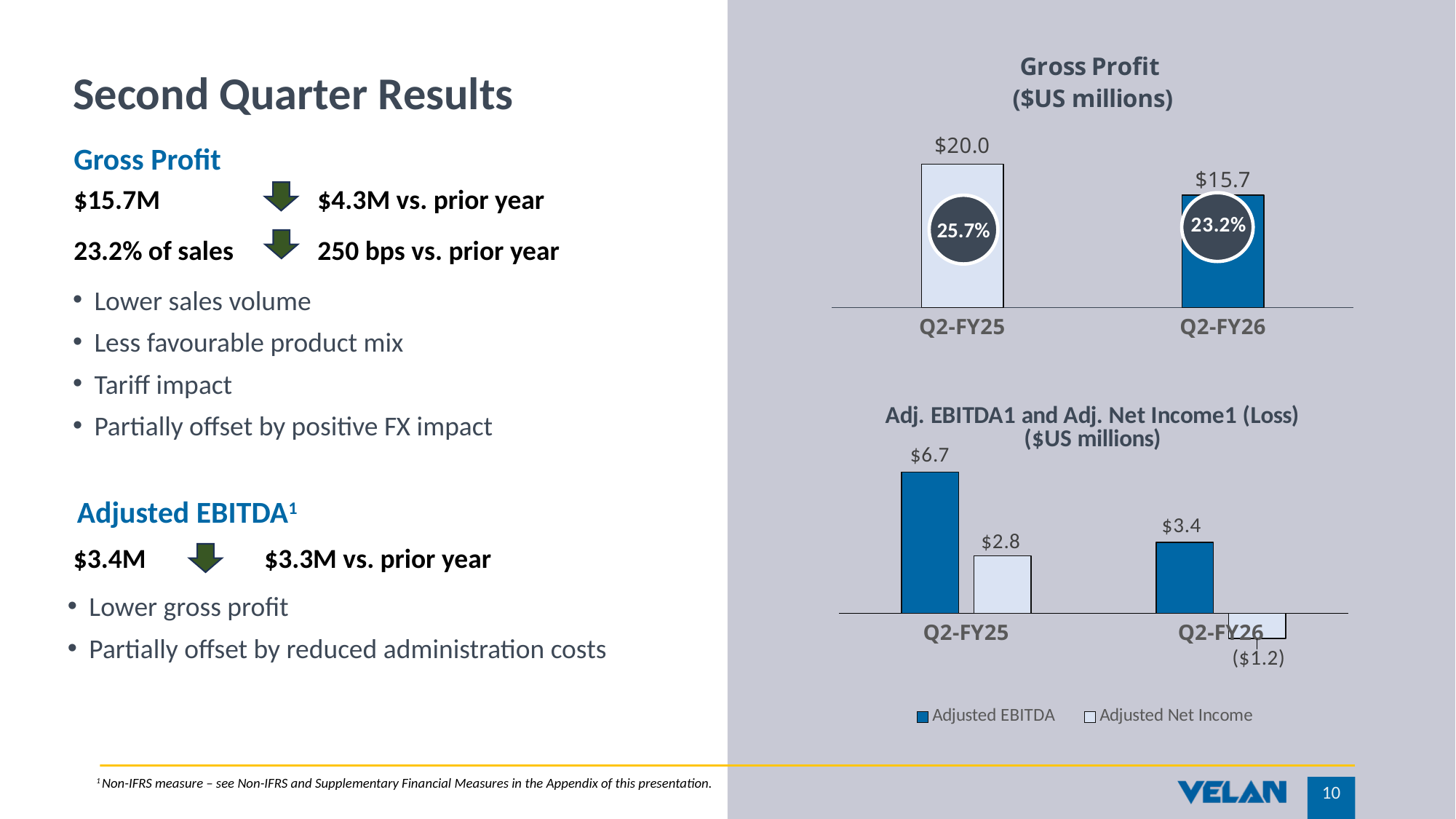
In the Adj. EBITDA and Adj. Net Income chart, does Adjusted EBITDA rise or fall from Q2-FY25 to Q2-FY26? Fall What type of chart is the Gross Profit chart? Bar chart In the Adj. EBITDA and Adj. Net Income chart, what is the Adjusted EBITDA for Q2-FY25? $6.7 In the Gross Profit chart, which quarter has the higher gross profit? Q2-FY25 In the Adj. EBITDA and Adj. Net Income chart, what is the Adjusted Net Income for Q2-FY26? ($1.2) In the Adj. EBITDA and Adj. Net Income chart, what is the Adjusted Net Income for Q2-FY25? $2.8 In the Gross Profit chart, what gross margin percentage is shown for Q2-FY25? 25.7% In the Gross Profit chart, what is the gross profit value for Q2-FY25? $20.0 In the Adj. EBITDA and Adj. Net Income chart, how many series does the legend list? 2 In the Gross Profit chart, what is the difference in gross profit between Q2-FY25 and Q2-FY26? $4.3 In the Gross Profit chart, how many quarters are plotted? 2 In the Gross Profit chart, what is the gross profit value for Q2-FY26? $15.7